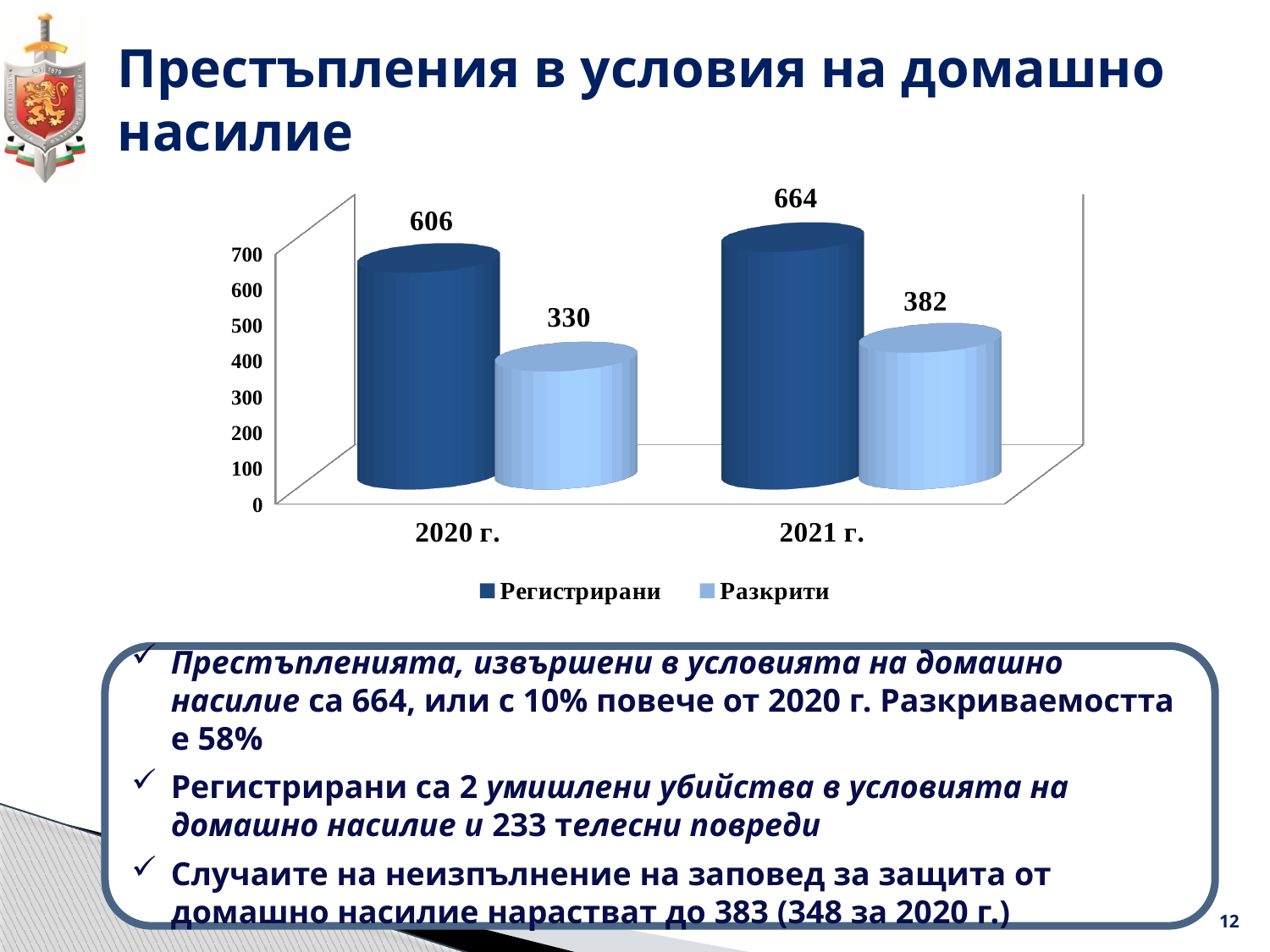
How many series does the legend list? 2 How many years are shown on the x axis? 2 Do the values for Разкрити rise or fall from 2020 г. to 2021 г.? Rise By how much did Регистрирани increase from 2020 г. to 2021 г.? 58 What is the value for Регистрирани in 2020 г.? 606 What is the value for Разкрити in 2021 г.? 382 Which year has the higher value for Регистрирани? 2021 г. What is the value for Разкрити in 2020 г.? 330 Which is larger: Разкрити in 2021 г. or Регистрирани in 2020 г.? Регистрирани in 2020 г. What kind of chart is shown on the slide? Bar chart Which year has the lower value for Разкрити? 2020 г. What is the difference between Регистрирани and Разкрити in 2021 г.? 282